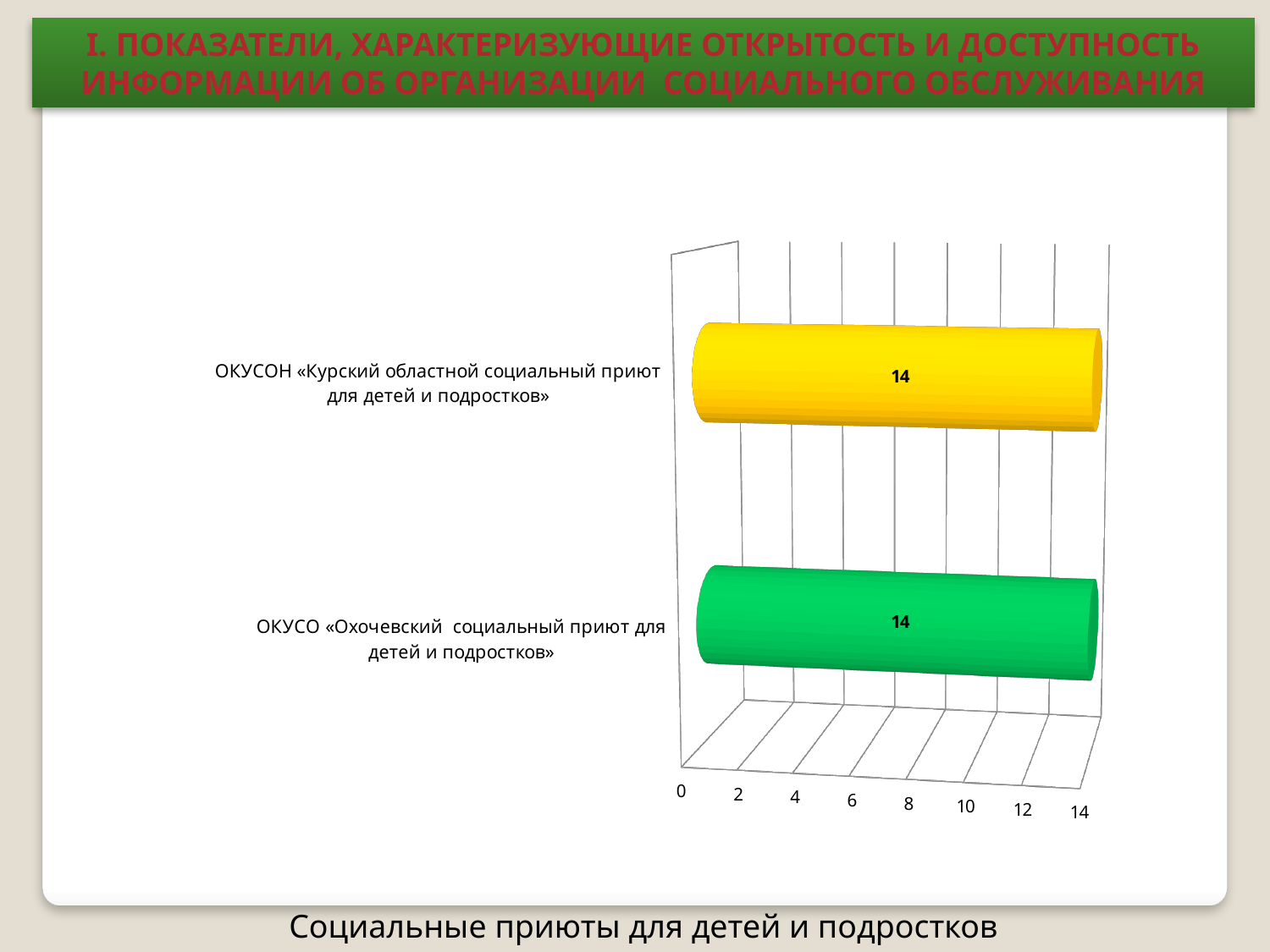
Is the value for ОКУСОН «Курский областной социальный приют для детей и подростков» greater or less than 8? greater How many categories are plotted in the chart? 2 What kind of chart is shown on the slide? Bar chart What colour is the bar for ОКУСО «Охочевский социальный приют для детей и подростков»? Green What is the difference between the values for ОКУСОН «Курский областной социальный приют для детей и подростков» and ОКУСО «Охочевский социальный приют для детей и подростков»? 0 What is the value for ОКУСО «Охочевский социальный приют для детей и подростков»? 14 Is the value for ОКУСО «Охочевский социальный приют для детей и подростков» greater or less than 10? greater Do the two categories have the same value or different values? The same value What is the highest value shown on the horizontal axis? 14 What is the value for ОКУСОН «Курский областной социальный приют для детей и подростков»? 14